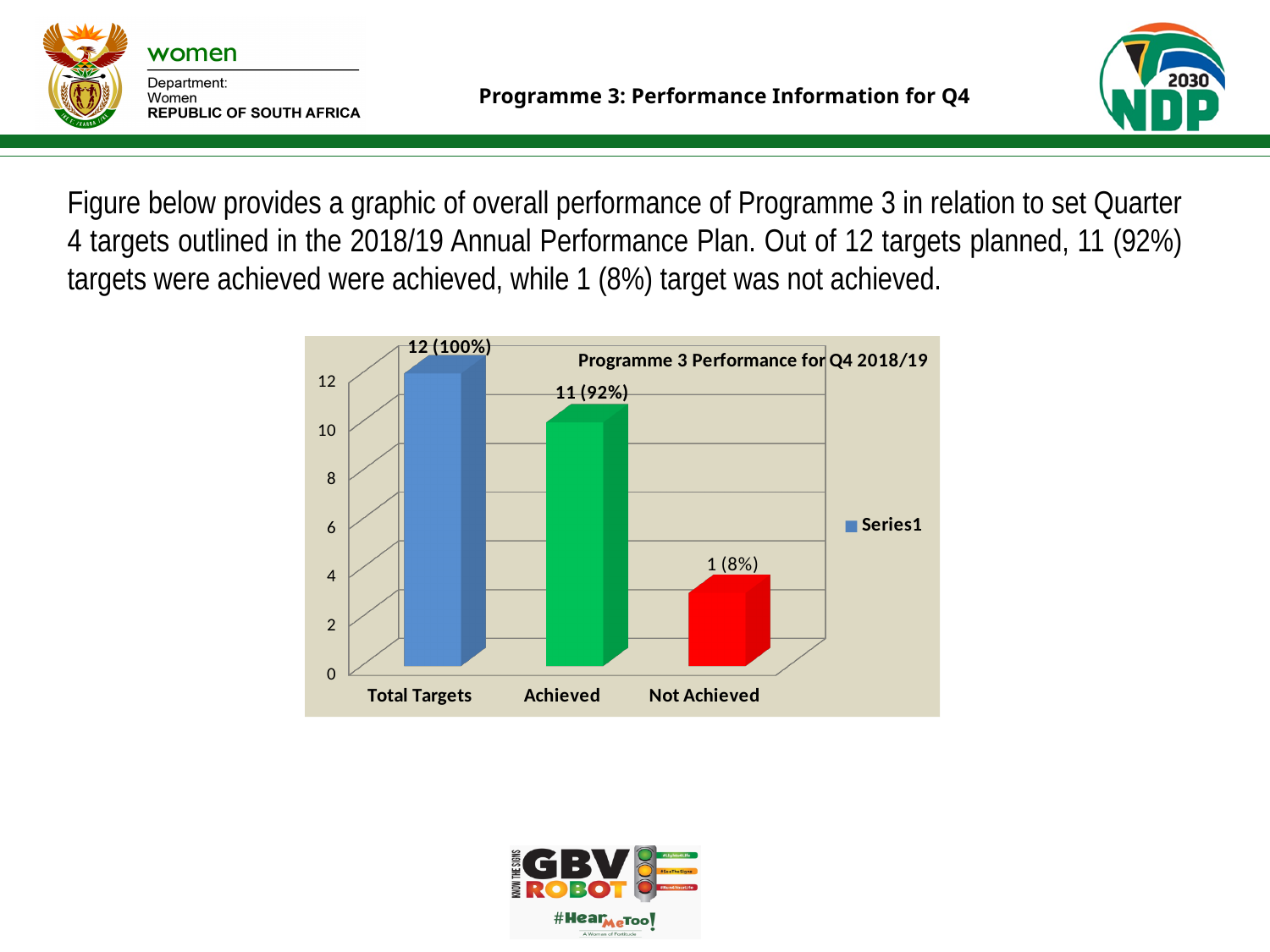
What is the value shown for Total Targets? 12 (100%) What is the value shown for Not Achieved? 1 (8%) Which is larger, the value for Achieved or the value for Not Achieved? Achieved How many categories are shown on the x axis? 3 What type of chart is shown on the slide? Bar chart What is the value shown for Achieved? 11 (92%) Which category has the lowest value? Not Achieved What is the difference between the Achieved and Not Achieved values? 10 Which category has the highest value? Total Targets What is the difference between the Total Targets and Achieved values? 1 What is the title of the chart? Programme 3 Performance for Q4 2018/19